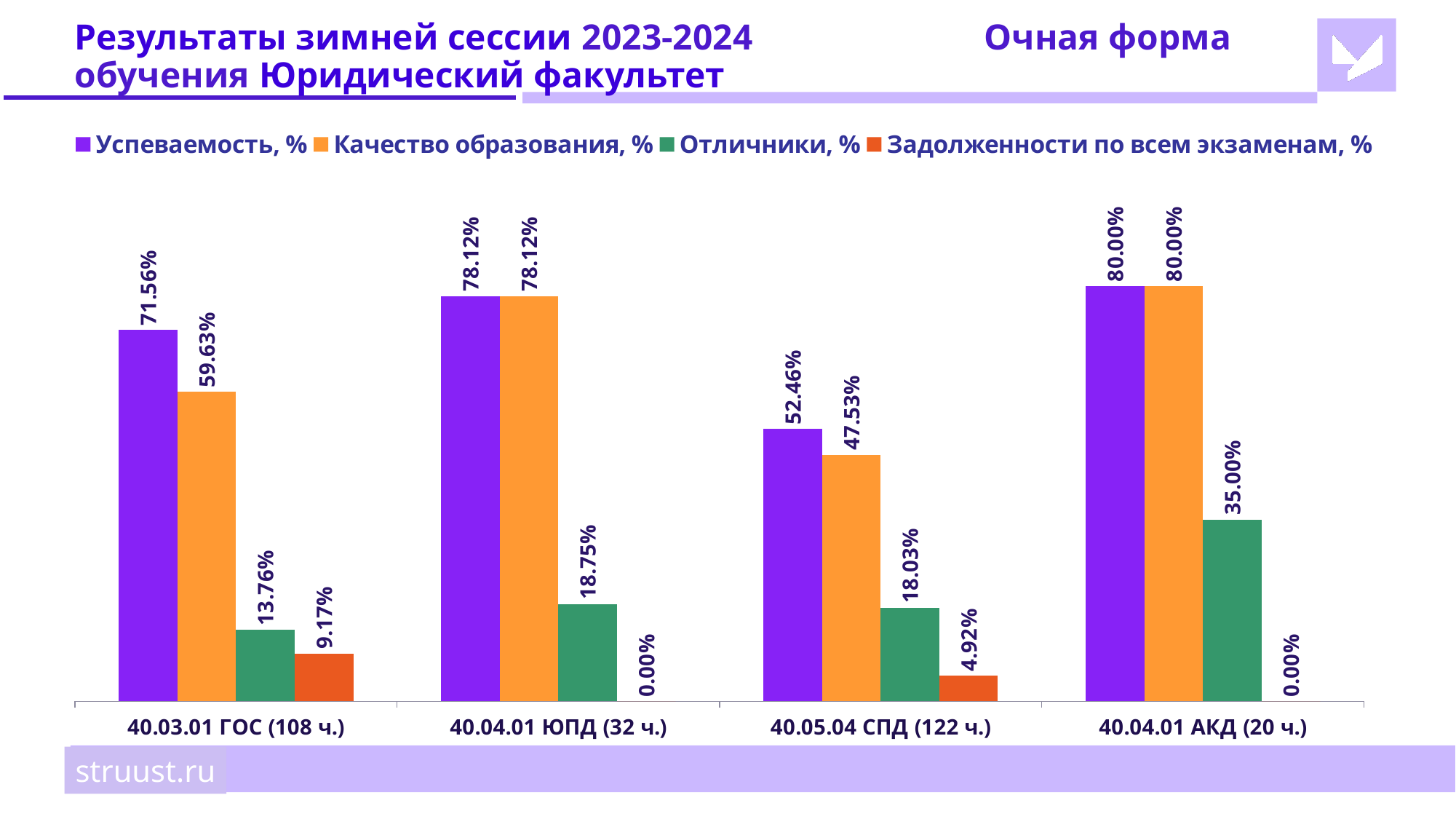
What is the value of Успеваемость, % for 40.03.01 ГОС (108 ч.)? 71.56% Which colour represents Задолженности по всем экзаменам, % in the legend? Red-orange What is the difference between Успеваемость, % and Качество образования, % for 40.03.01 ГОС (108 ч.)? 11.93% Which is larger: Отличники, % for 40.04.01 ЮПД (32 ч.) or Отличники, % for 40.04.01 АКД (20 ч.)? 40.04.01 АКД (20 ч.) What is the value of Качество образования, % for 40.05.04 СПД (122 ч.)? 47.53% What is the value of Отличники, % for 40.04.01 АКД (20 ч.)? 35.00% Which category has the highest value for Успеваемость, %? 40.04.01 АКД (20 ч.) Which category has the lowest value for Качество образования, %? 40.05.04 СПД (122 ч.) What kind of chart is shown on the slide? Bar chart What is the value of Задолженности по всем экзаменам, % for 40.03.01 ГОС (108 ч.)? 9.17% How many series does the legend list? 4 How many categories are shown on the x axis? 4